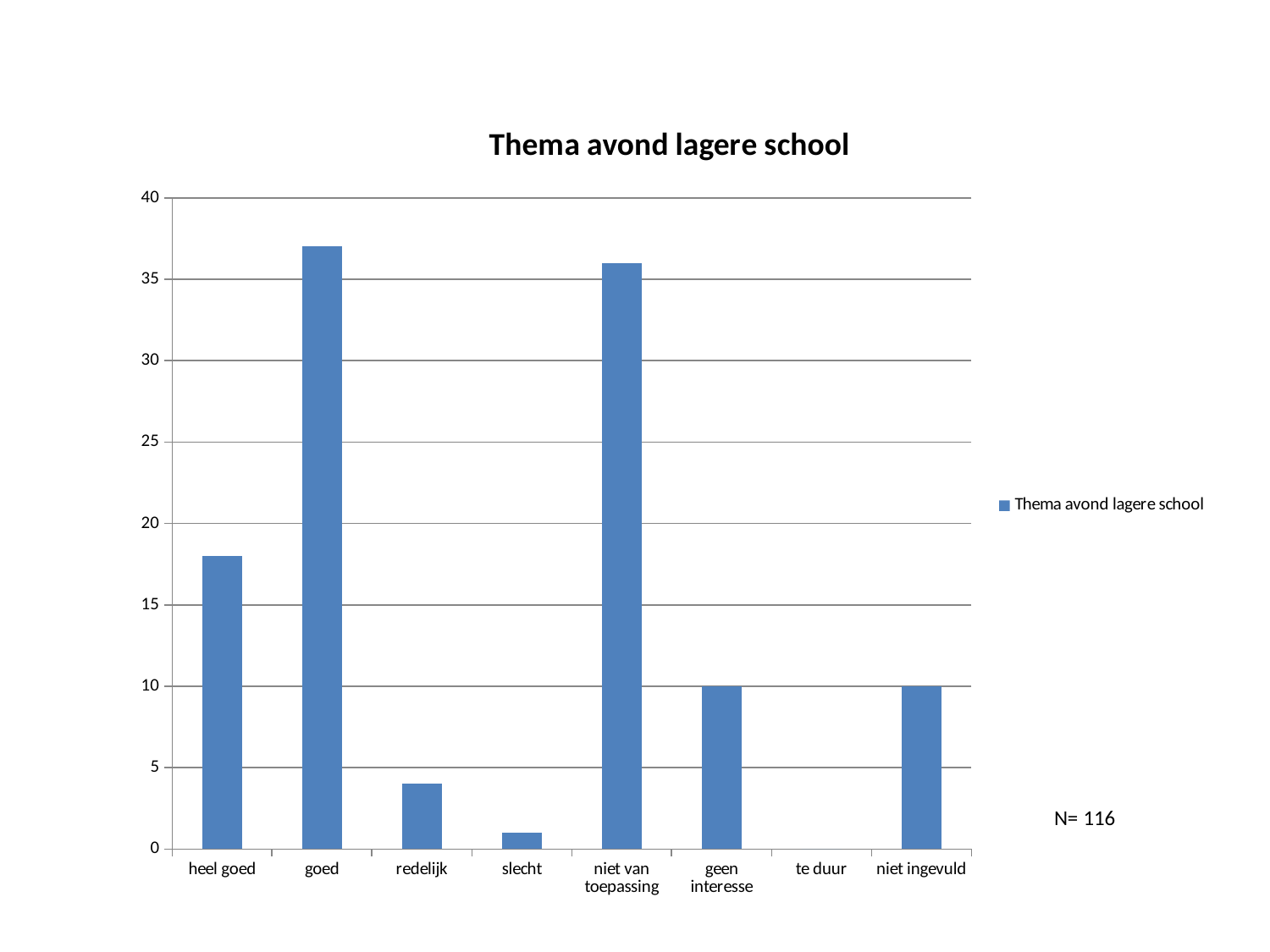
Which category has the lowest value? te duur What is the title of the chart? Thema avond lagere school Which is larger, the value for 'heel goed' or the value for 'goed'? goed What is the value for 'geen interesse'? 10 How many series does the legend list? 1 What is the value for 'niet ingevuld'? 10 Is the value for 'niet van toepassing' greater or less than 35? greater What type of chart is shown on the slide? bar chart Is the value for 'redelijk' greater or less than 5? less How many categories are shown on the x axis of the chart? 8 What is the value for 'te duur'? 0 Is the value for 'heel goed' greater or less than 15? greater